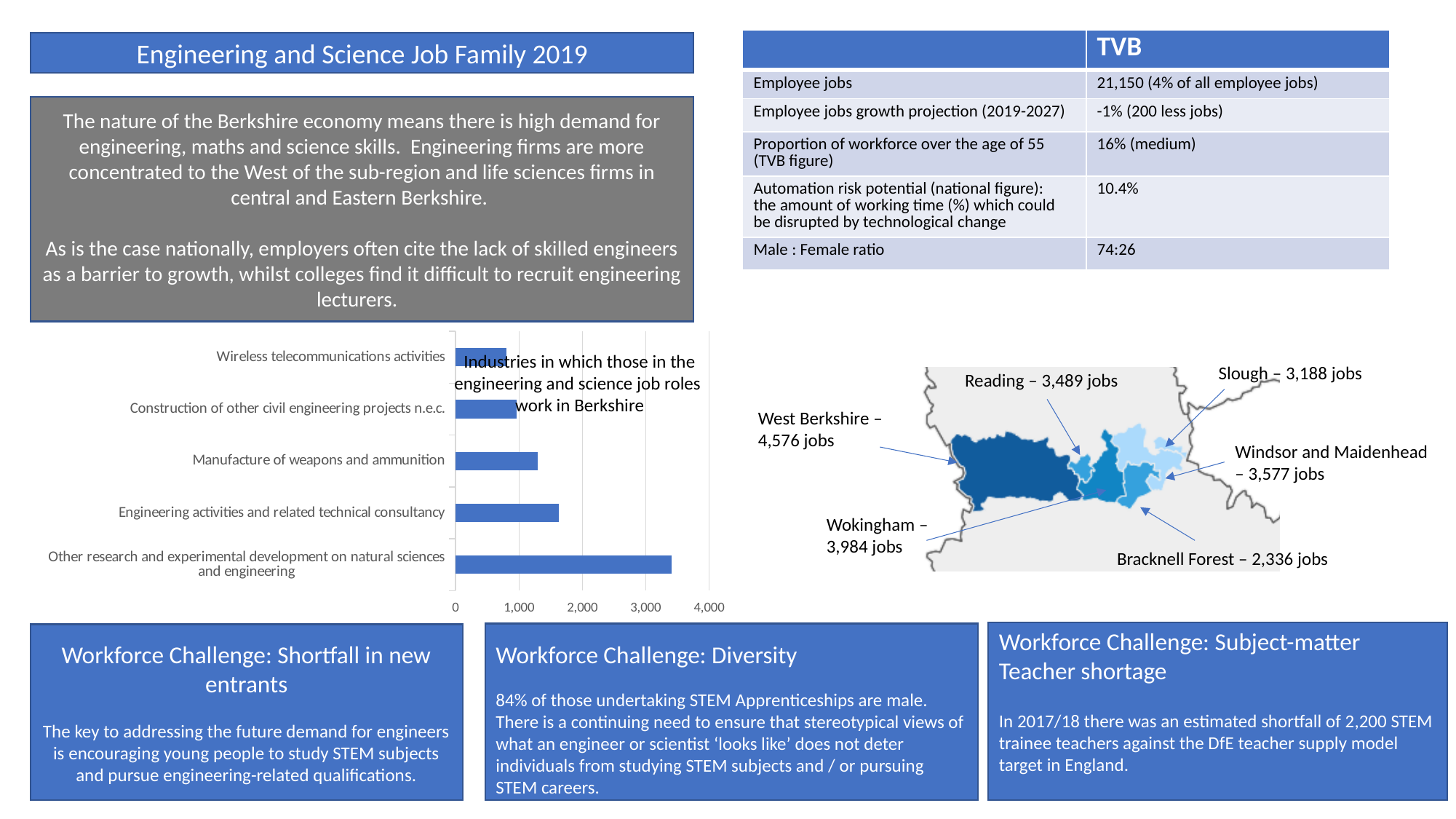
Is the value for Other research and experimental development on natural sciences and engineering greater or less than 3,000? greater Which is larger: the value for Wireless telecommunications activities or the value for Other research and experimental development on natural sciences and engineering? Other research and experimental development on natural sciences and engineering Is the value for Engineering activities and related technical consultancy greater or less than 2,000? less Which industry has the highest value in the bar chart? Other research and experimental development on natural sciences and engineering How many industry categories does the bar chart show? 5 Is the value for Wireless telecommunications activities greater or less than 1,000? less What kind of chart is shown on the slide? bar chart Which is larger: the value for Engineering activities and related technical consultancy or the value for Manufacture of weapons and ammunition? Engineering activities and related technical consultancy What is the title of the bar chart? Industries in which those in the engineering and science job roles work in Berkshire